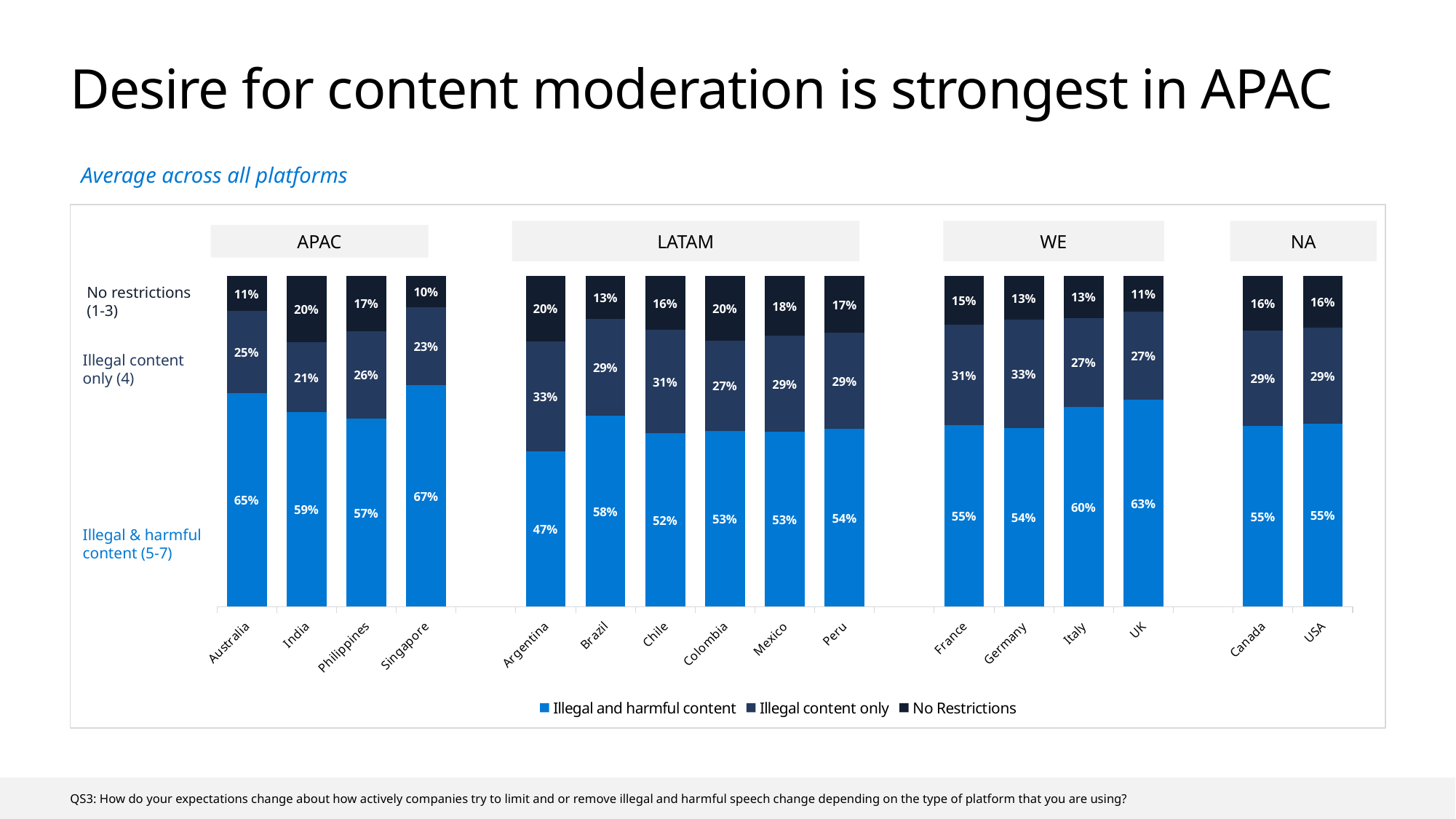
Which regional group contains the most countries? LATAM Which is larger, the 'Illegal and harmful content' value for UK or for Italy? UK What is the 'No Restrictions' value for Argentina? 20% Which country has the lowest 'Illegal and harmful content' value? Argentina What is the value for 'Illegal and harmful content' for Singapore? 67% Which country has the highest 'Illegal and harmful content' value? Singapore How many countries are shown on the x axis? 16 What kind of chart is shown on the slide? Stacked bar chart How many series does the legend list? 3 What is the difference between the 'Illegal and harmful content' values for Singapore and Argentina? 20% What is the total of the stacked bar for Brazil? 100% What is the 'Illegal content only' value for Germany? 33%